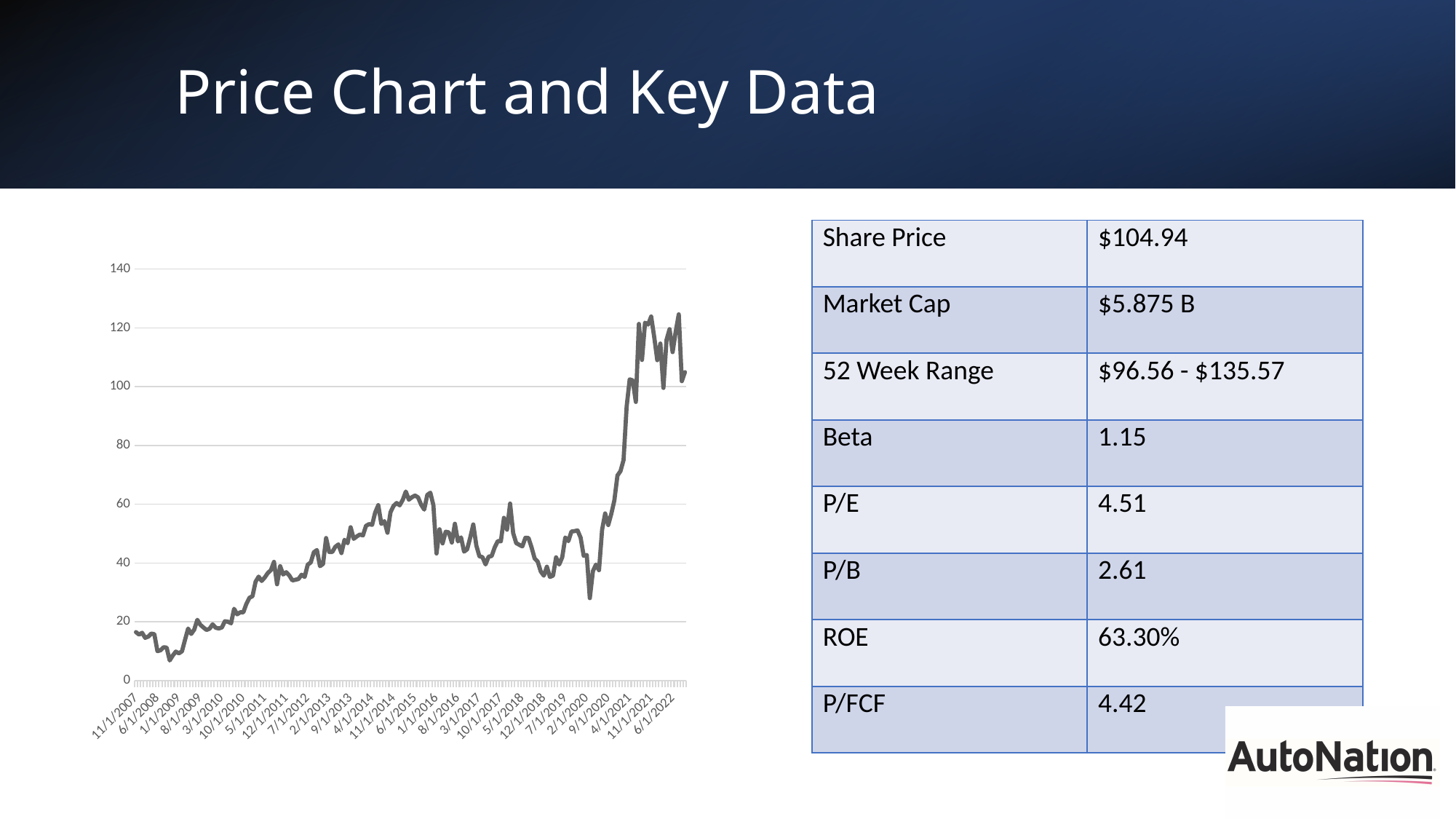
How many date labels are shown on the x axis of the chart? 26 What kind of chart is shown on the slide? line chart Which is larger, the value at 1/1/2009 or the value at 11/1/2021? 11/1/2021 Is the value at 11/1/2007 greater or less than 40? less Is the value at 1/1/2009 greater or less than 20? less Which is larger, the value at 11/1/2007 or the value at 6/1/2022? 6/1/2022 Overall, does the line rise or fall from 11/1/2007 to 6/1/2022? rise What is the first date label on the x axis of the chart? 11/1/2007 Is the value at 4/1/2021 greater or less than 80? greater What is the highest value shown on the y axis of the chart? 140